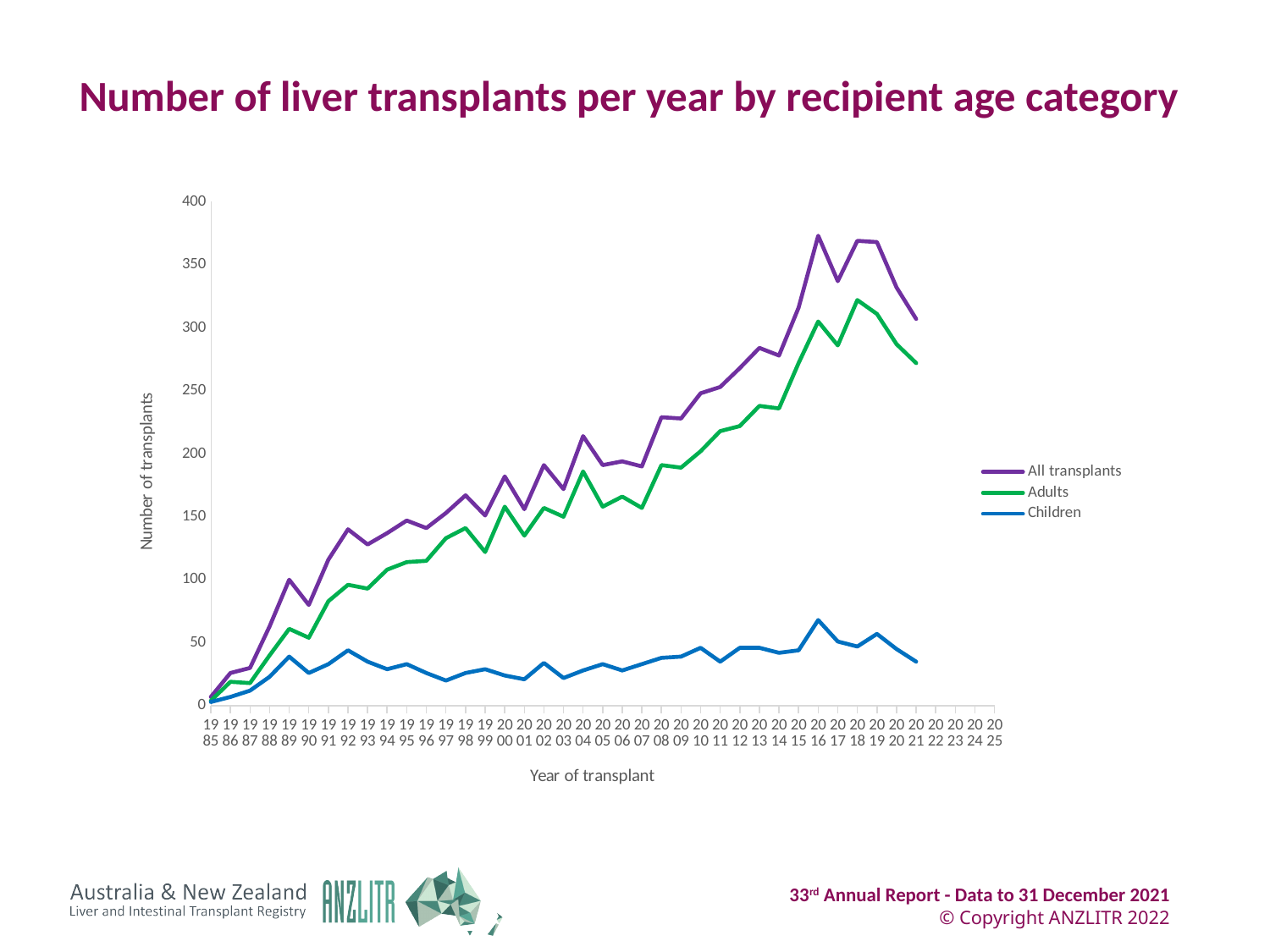
In 2016, which is larger: the value for Adults or the value for Children? Adults Which series has the lowest values across the chart? Children Which series has the highest values across the chart? All transplants Is the value for All transplants in 2016 greater or less than 350? greater Is the value for Adults in 2021 greater or less than 250? greater Is the value for Children in 2016 greater or less than 50? greater How many series does the legend list? 3 What kind of chart is shown on the slide? Line chart Do the values for All transplants generally rise or fall from 1985 to 2016? rise What are the three series named in the legend? All transplants, Adults, Children What is the label on the vertical axis? Number of transplants